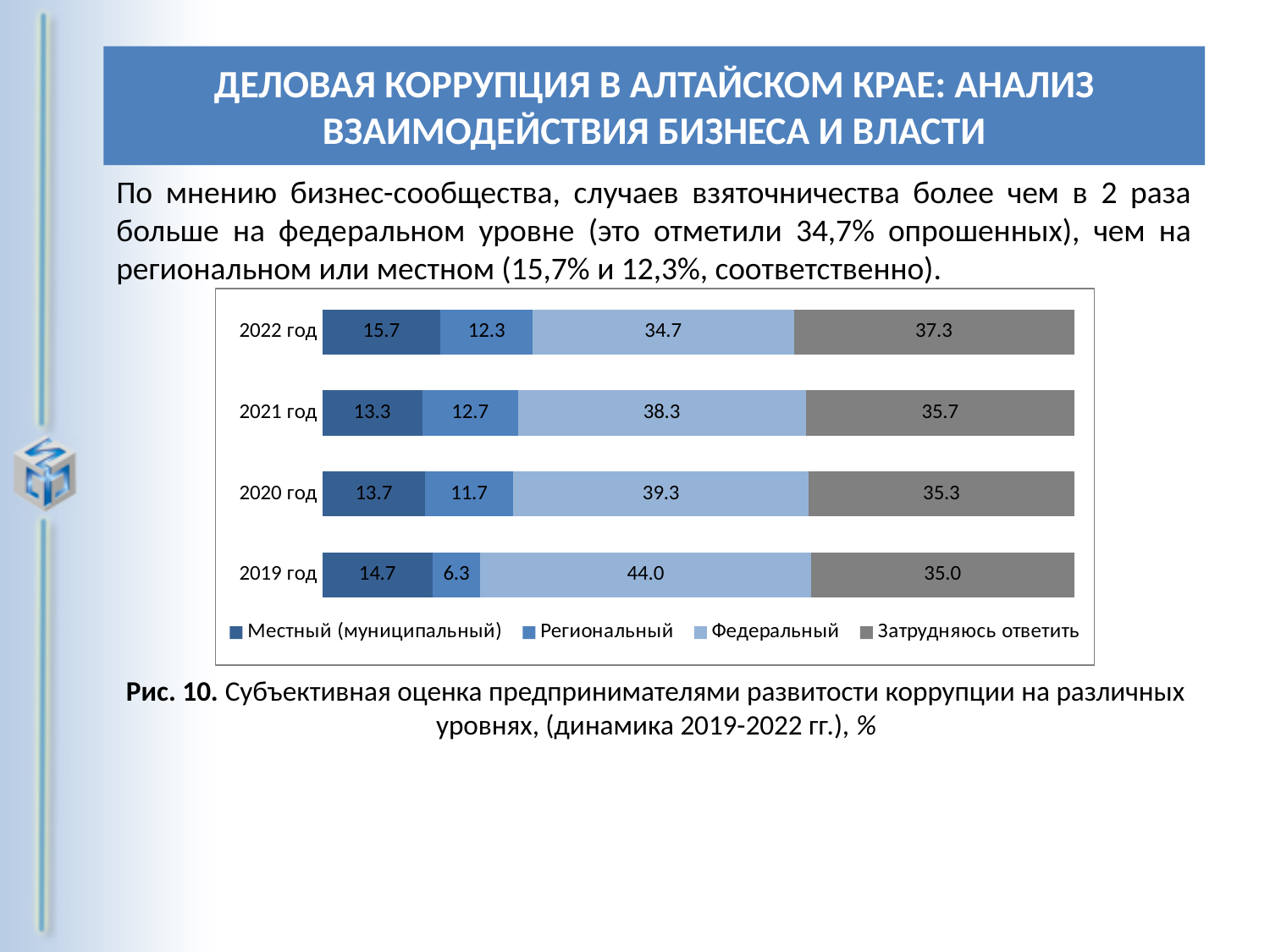
What is the difference between the Федеральный values for 2019 год and 2022 год? 9.3 In which year is the Региональный value the lowest? 2019 год What is the total of the stacked bar for 2022 год? 100.0 What kind of chart is shown on the slide? Stacked bar chart How many years (categories) are shown in the chart? 4 What is the value for Региональный in 2022 год? 12.3 How many series does the legend list? 4 What is the value for Местный (муниципальный) in 2020 год? 13.7 Which year has the larger Затрудняюсь ответить value, 2022 год or 2021 год? 2022 год In which year is the Федеральный value the highest? 2019 год Does the Федеральный value rise or fall from 2019 год to 2022 год? Fall What is the value for Федеральный in 2019 год? 44.0